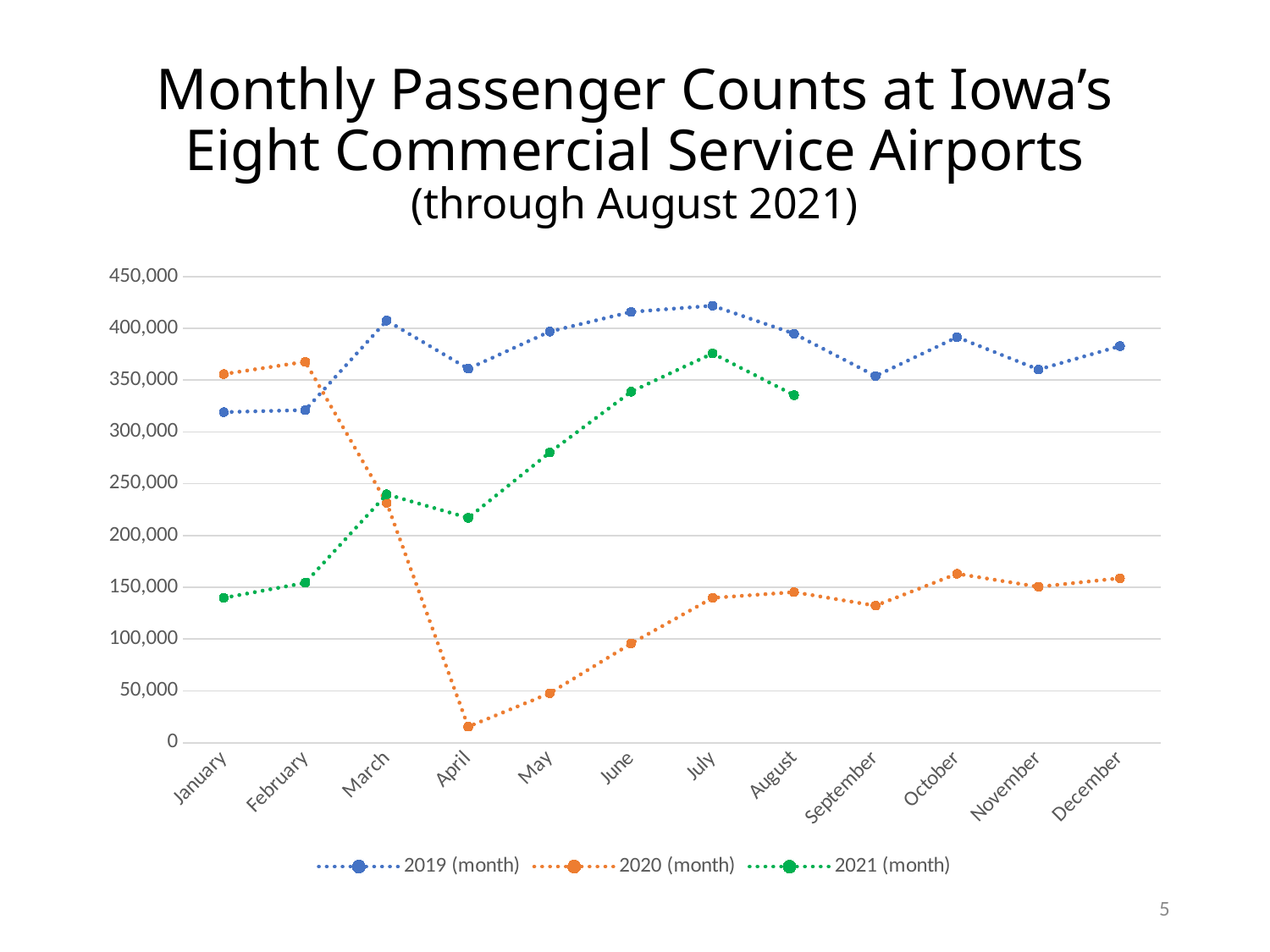
Is the 2020 (month) value for April greater or less than 50,000? less Which series has the larger value in March: 2019 (month) or 2020 (month)? 2019 (month) What kind of chart is shown on the slide? line chart Is the 2019 (month) value for March greater or less than 400,000? greater In which month is the 2019 (month) passenger count highest? July How many series does the legend list? 3 In which month is the 2020 (month) passenger count lowest? April Does the 2020 (month) series rise or fall from February to April? fall How many months are shown along the x axis? 12 In which month is the 2021 (month) passenger count highest? July How many data points are plotted for the 2021 (month) series? 8 Which series has the larger value in January: 2019 (month) or 2020 (month)? 2020 (month)